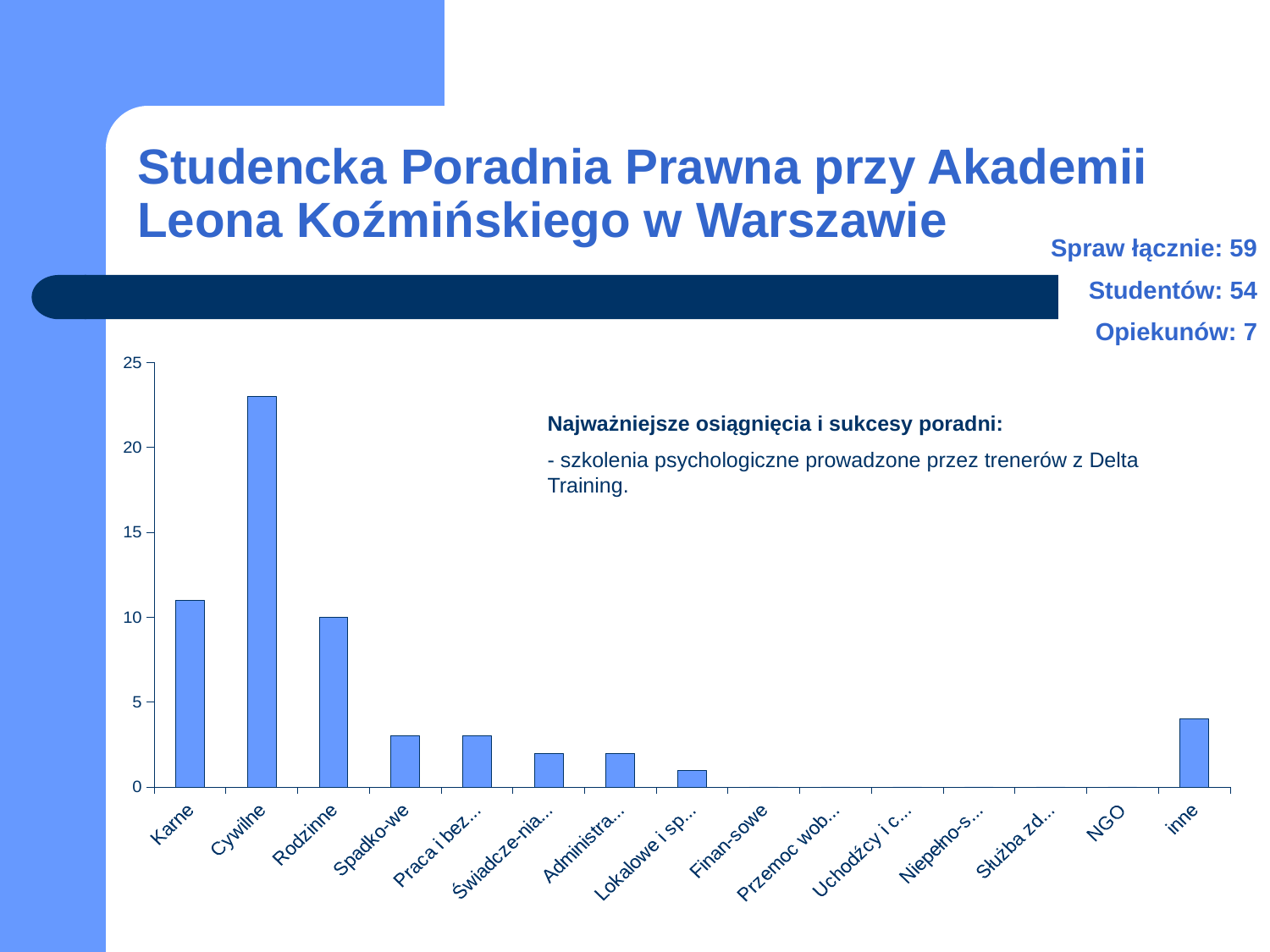
Which is larger, the value for Cywilne or the value for Karne? Cywilne Which is larger, the value for inne or the value for Lokalowe i sp...? inne Is the value for Spadko-we greater or less than 5? less Is the value for Karne greater or less than 10? greater Is the value for Cywilne greater or less than 20? greater What colour are the bars in the chart? blue Which is larger, the value for Rodzinne or the value for Spadko-we? Rodzinne What is the value for Rodzinne? 10 What kind of chart is shown on the slide? bar chart Which category has the highest value in the chart? Cywilne How many categories are shown on the x axis of the chart? 15